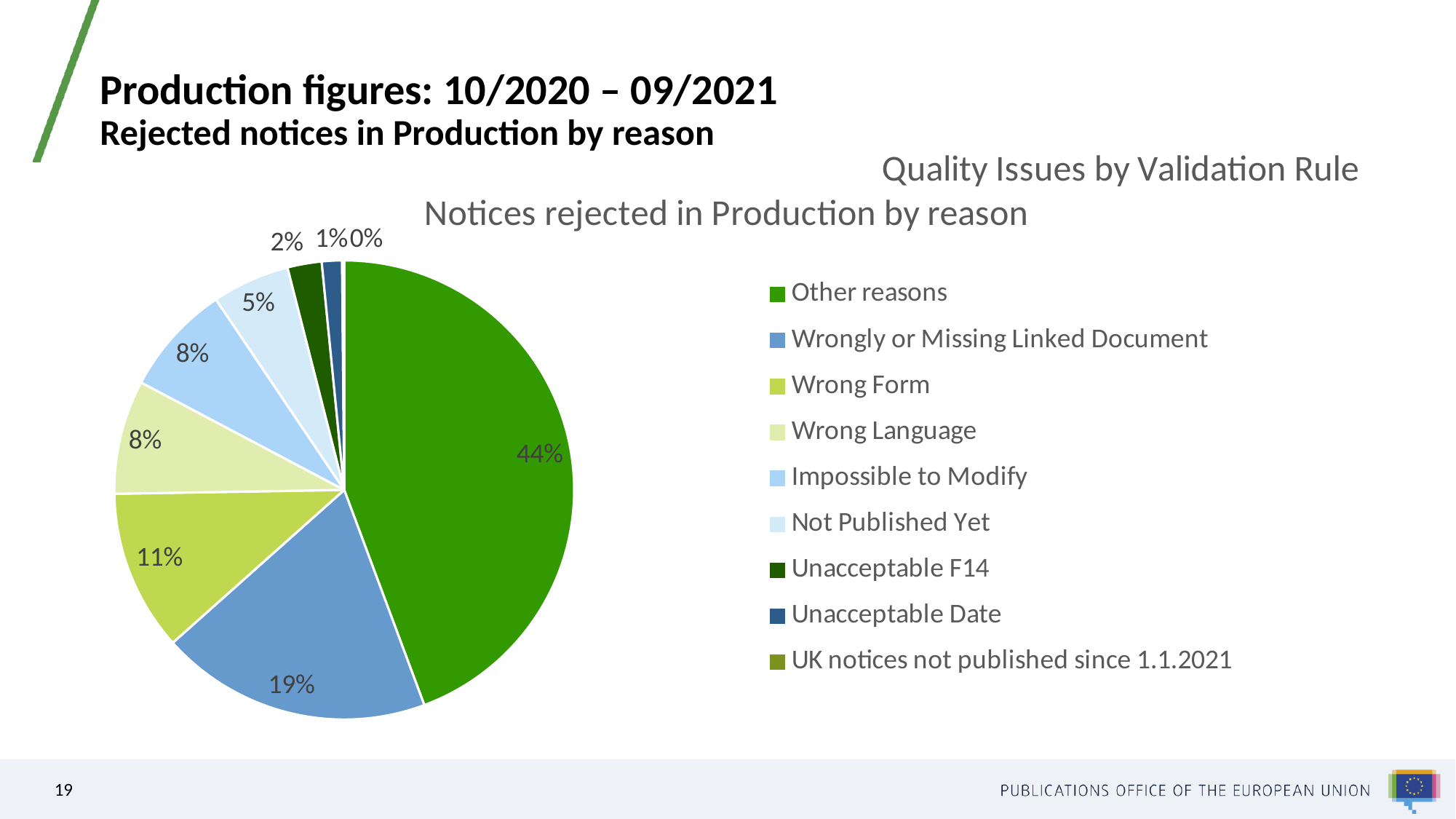
What share of the pie is 'Other reasons'? 44% Which slice is larger: 'Wrongly or Missing Linked Document' or 'Wrong Form'? Wrongly or Missing Linked Document Which reason has the largest slice of the pie? Other reasons Which reason has the smallest slice of the pie? UK notices not published since 1.1.2021 What is the title of the pie chart? Notices rejected in Production by reason What share of the pie is 'Wrong Form'? 11% What is the difference in percentage points between the 'Other reasons' slice and the 'Wrongly or Missing Linked Document' slice? 25 percentage points What share of the pie is 'Wrongly or Missing Linked Document'? 19% What kind of chart is shown on the slide? pie chart How many entries does the legend of the pie chart list? 9